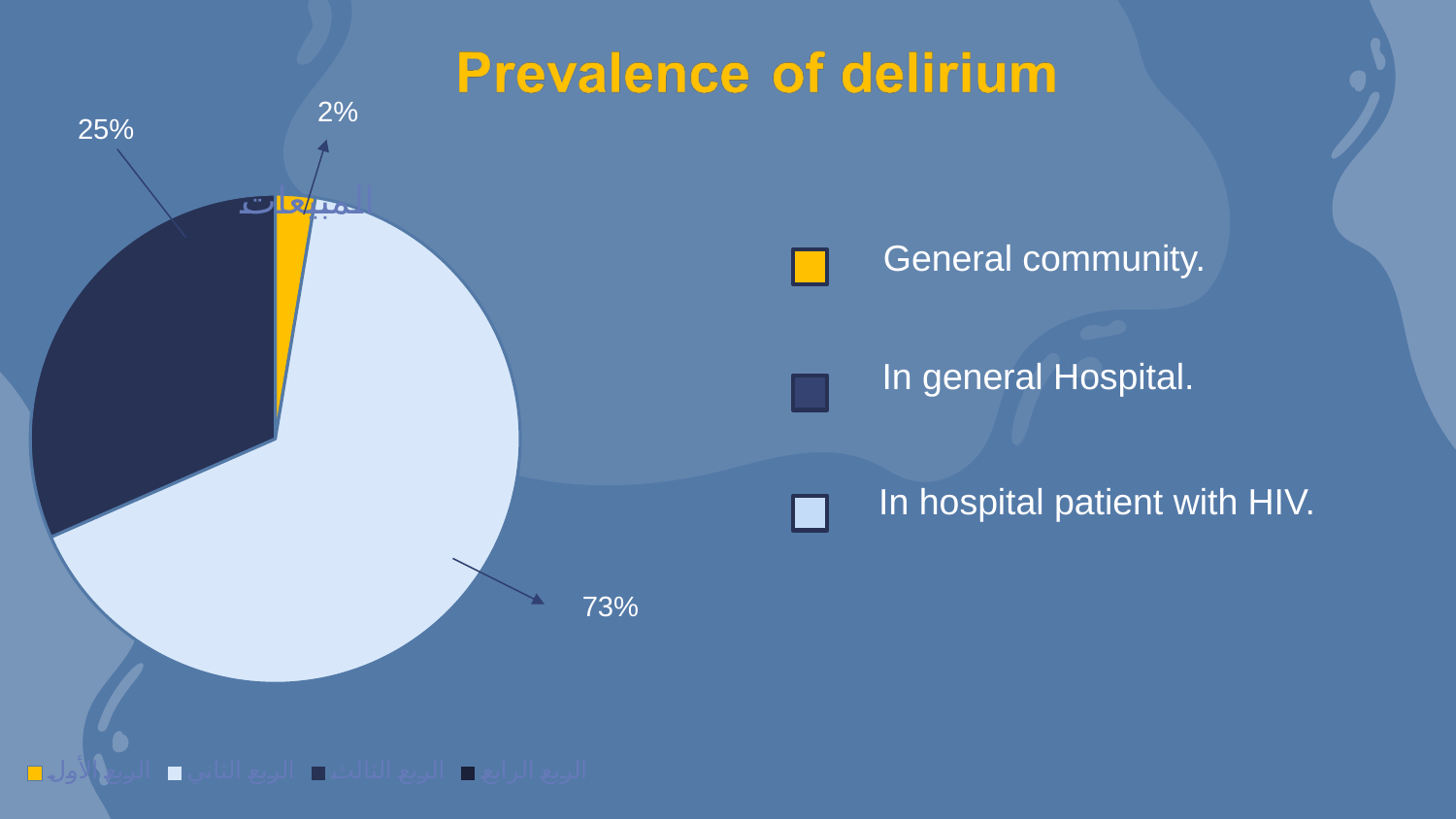
What is the difference in percentage points between In hospital patient with HIV and In general Hospital? 48 What percentage is shown for General community? 2% Which category has the smallest slice of the pie? General community What percentage is shown for In general Hospital? 25% Which category has the largest slice of the pie? In hospital patient with HIV How many slices does the pie chart have? 3 Which is larger, the slice for In general Hospital or the slice for General community? In general Hospital What percentage is shown for In hospital patient with HIV? 73% What kind of chart is shown on the slide? Pie chart What do the three labelled percentages on the pie add up to? 100% What colour is the slice for General community? Yellow What is the title of the slide? Prevalence of delirium